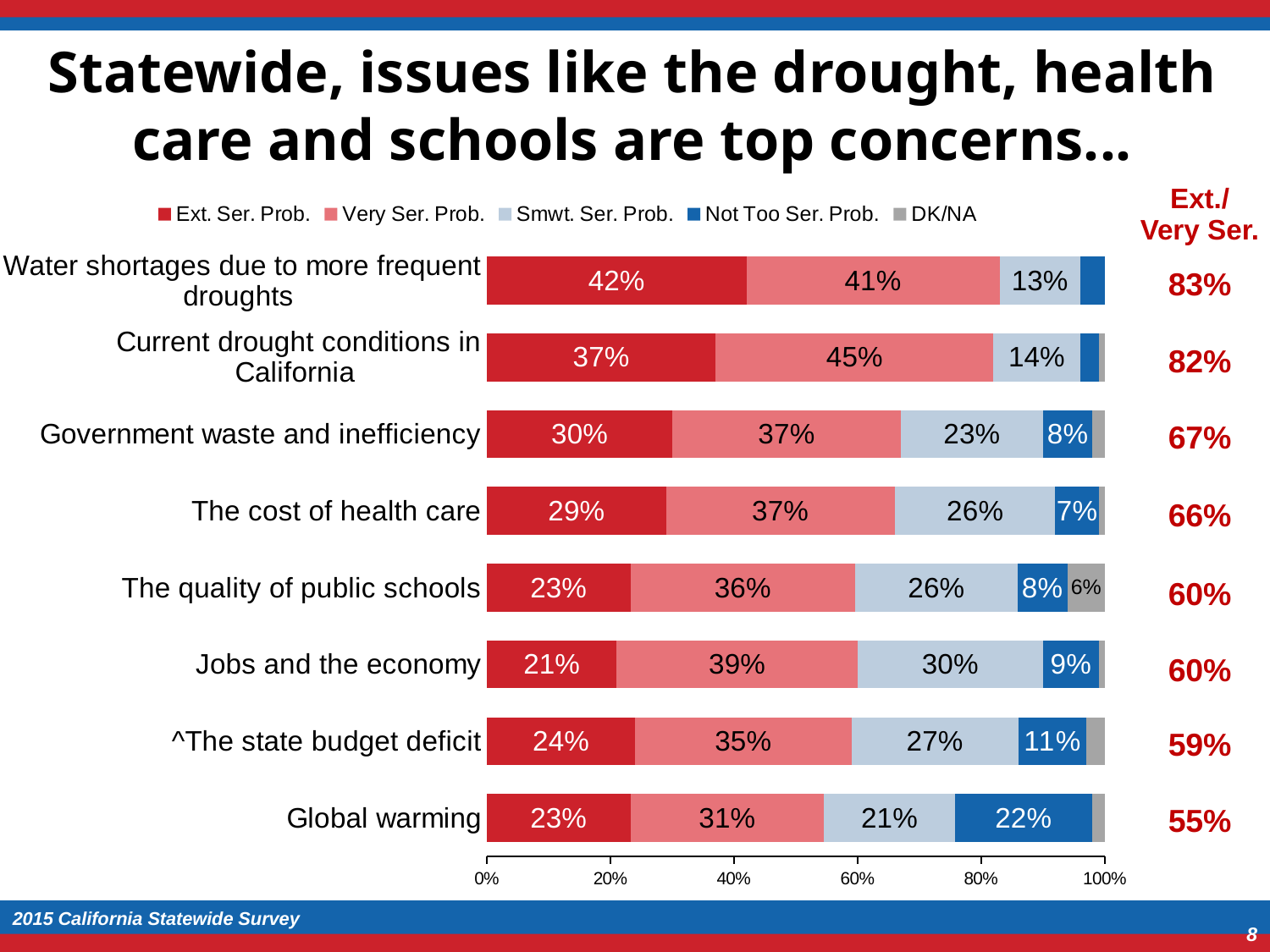
Which issue has the highest Ext. Ser. Prob. value? Water shortages due to more frequent droughts What is the Not Too Ser. Prob. value for global warming? 22% What percentage of respondents rated water shortages due to more frequent droughts as an extremely serious problem (Ext. Ser. Prob.)? 42% Which issue has the highest Not Too Ser. Prob. value? Global warming How many series does the legend list? 5 How many issues are plotted in the chart? 8 What is the difference between the Very Ser. Prob. values for current drought conditions in California and water shortages due to more frequent droughts? 4 percentage points Which issue has the lowest Ext. Ser. Prob. value? Jobs and the economy What is the Very Ser. Prob. value for current drought conditions in California? 45% Which has a larger Smwt. Ser. Prob. value: jobs and the economy or the state budget deficit? Jobs and the economy What type of chart is shown on the slide? Stacked bar chart What is the combined Ext./Very Ser. figure shown for the cost of health care? 66%